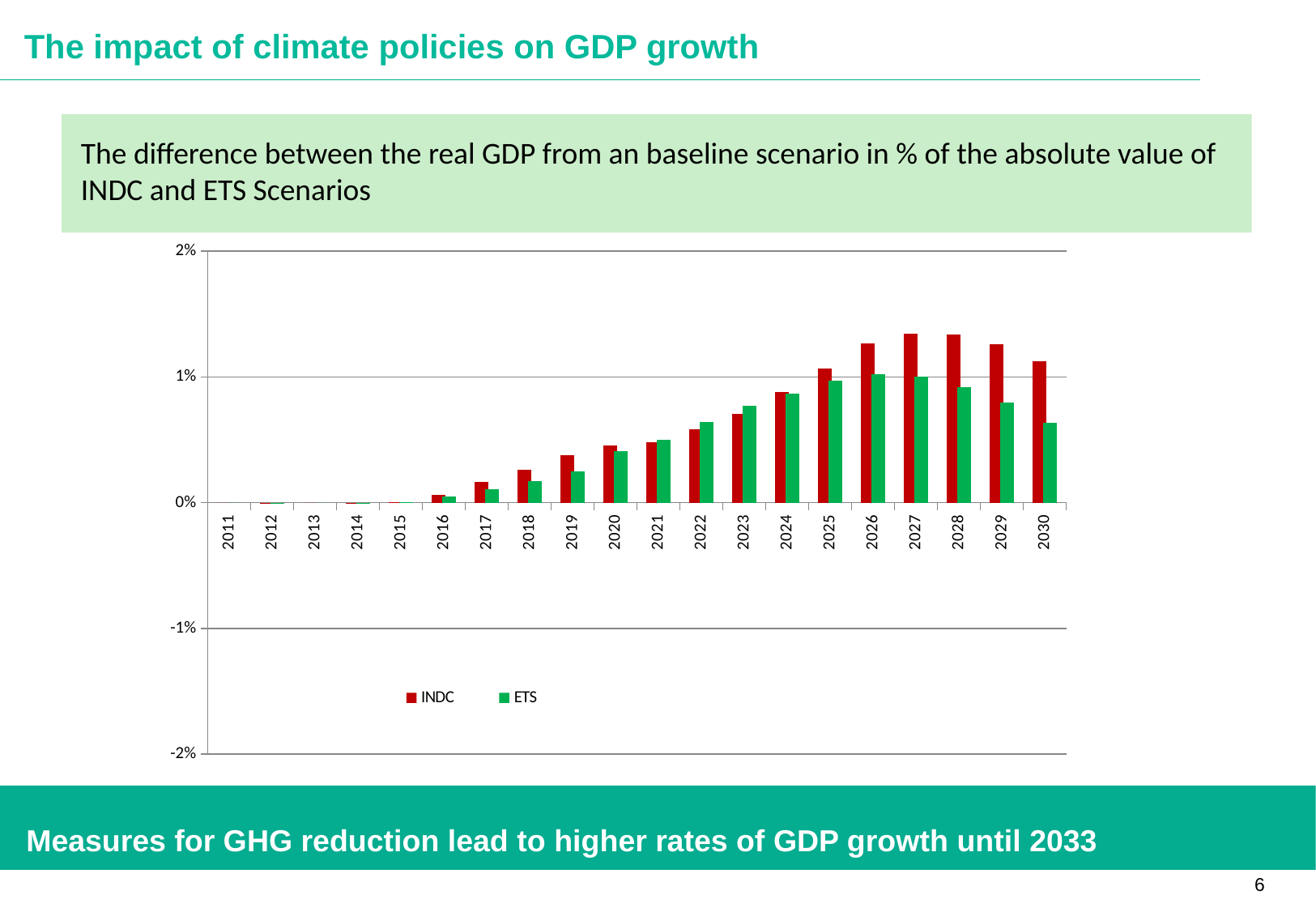
Do the INDC values rise or fall from 2016 to 2025? rise Which series is shown in red in the chart? INDC In 2022, which series has the larger value, INDC or ETS? ETS How many series does the legend list? 2 In 2030, which series has the larger value, INDC or ETS? INDC Is the ETS value for 2030 greater or less than 1%? less Is the INDC value for 2030 greater or less than 1%? greater Is the INDC value for 2027 greater or less than 1%? greater How many years are shown on the x axis of the chart? 20 What kind of chart is shown on the slide? bar chart What are the two series named in the legend? INDC and ETS